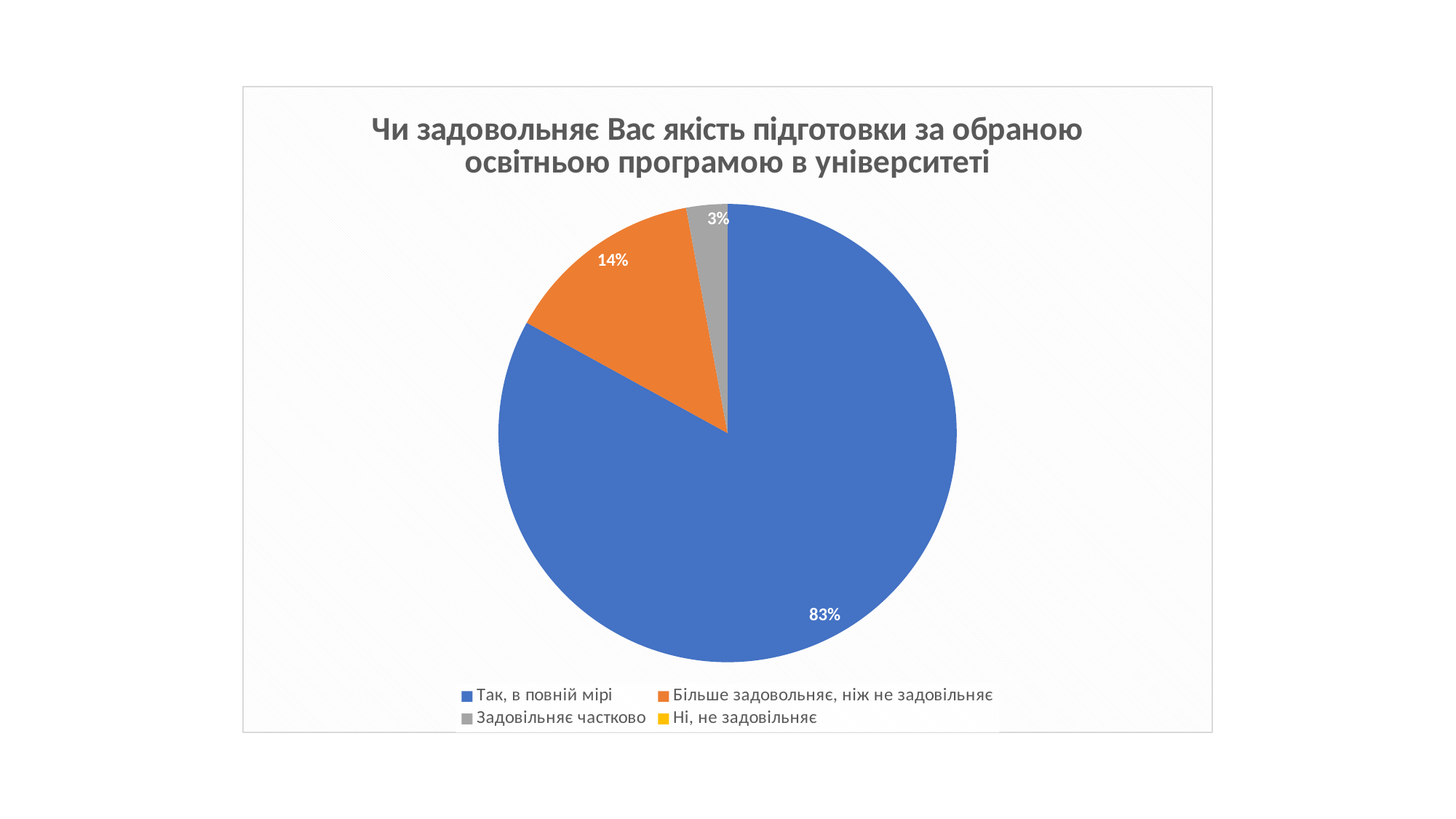
What percentage of the pie is the slice for "Так, в повній мірі"? 83% What share of the pie does the blue slice represent? 83% How many entries does the legend list? 4 What percentage is shown for "Більше задовольняє, ніж не задовільняє"? 14% What percentage is shown for "Задовільняє частково"? 3% What is the title of the chart? Чи задовольняє Вас якість підготовки за обраною освітньою програмою в університеті Which category has the largest slice of the pie? Так, в повній мірі What is the difference in percentage points between the "Так, в повній мірі" slice and the "Більше задовольняє, ніж не задовільняє" slice? 69 percentage points Which of the labelled slices is the smallest? Задовільняє частково What type of chart is shown on the slide? Pie chart Which is larger: the slice for "Більше задовольняє, ніж не задовільняє" or the slice for "Задовільняє частково"? Більше задовольняє, ніж не задовільняє What colour is the slice for "Так, в повній мірі"? Blue